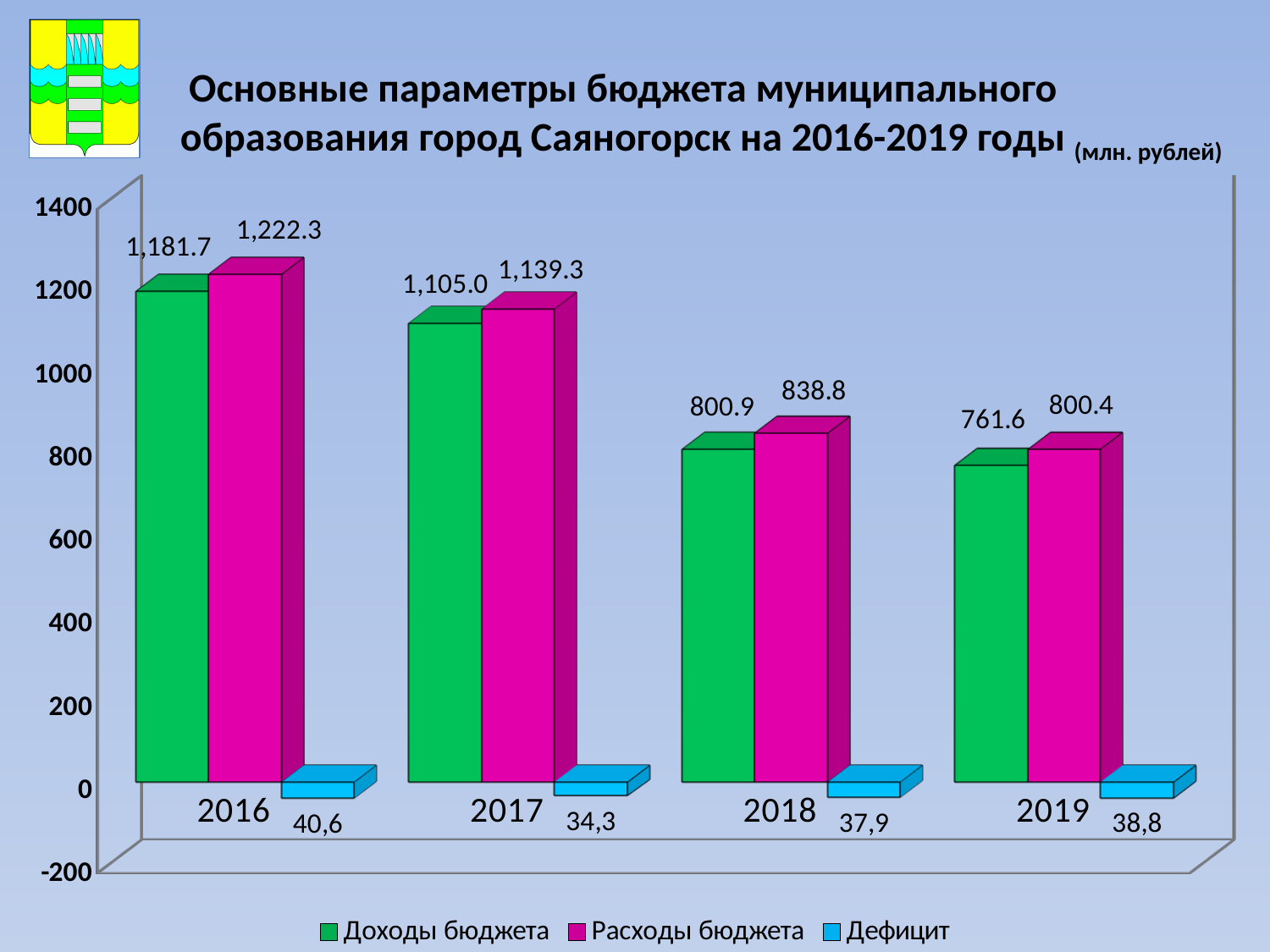
In which year is Расходы бюджета lowest? 2019 What is the value of Расходы бюджета for 2018? 838.8 Do the values of Доходы бюджета rise or fall from 2016 to 2019? Fall How many series does the legend list? 3 What kind of chart is shown on the slide? Bar chart What is the value of Расходы бюджета for 2019? 800.4 In which year is Доходы бюджета highest? 2016 What is the difference between Расходы бюджета and Доходы бюджета in 2016? 40.6 What is the difference between Доходы бюджета in 2016 and in 2017? 76.7 What is the value of Доходы бюджета for 2016? 1,181.7 Which is larger in 2018: Доходы бюджета or Расходы бюджета? Расходы бюджета What is the value of Дефицит for 2017? 34,3